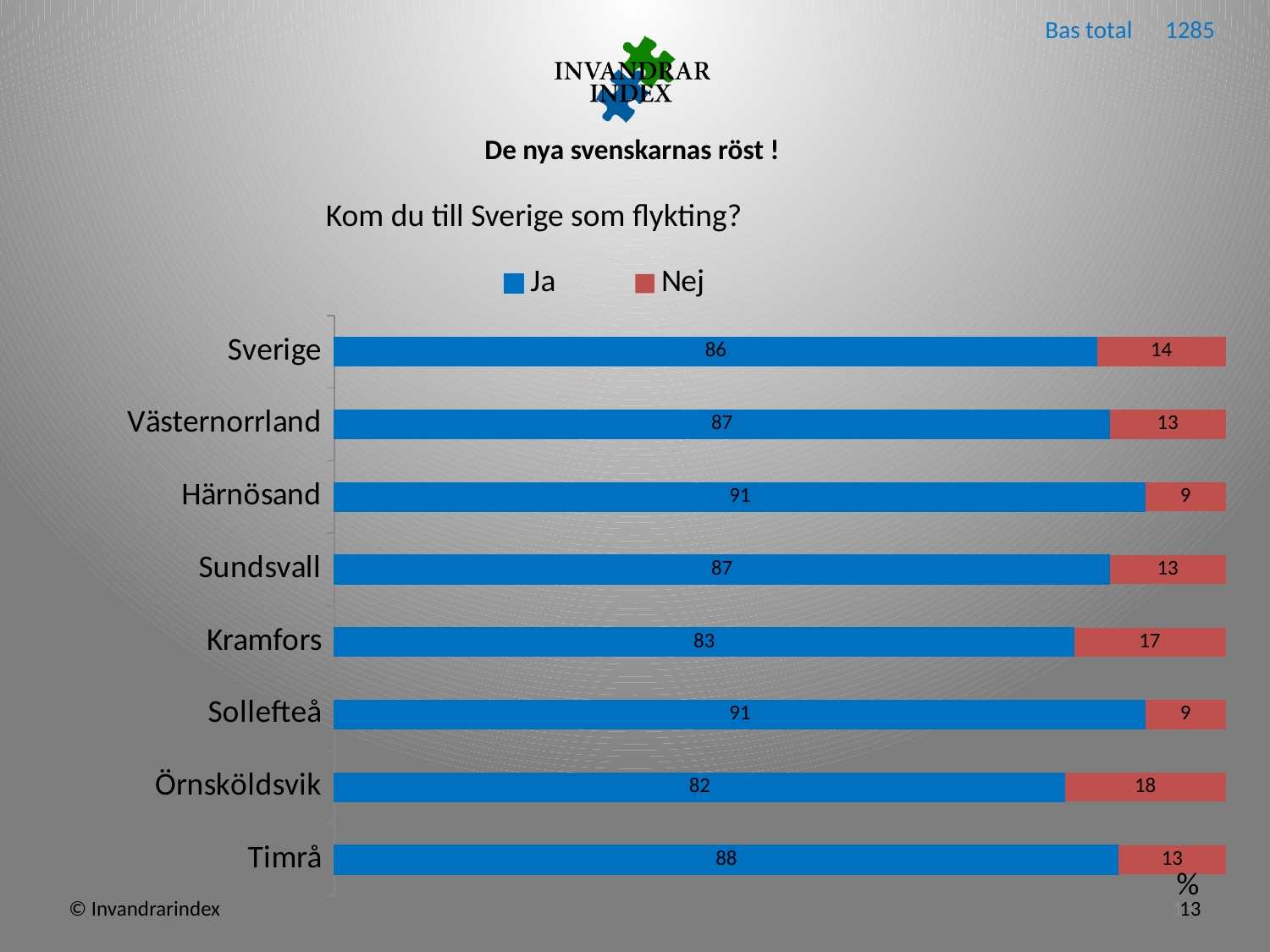
What is the total of the stacked bar for Sverige? 100 Which is larger, the Ja value for Sundsvall or the Ja value for Örnsköldsvik? Sundsvall Which category has the lowest value for Ja? Örnsköldsvik How many series does the legend list? 2 How many categories are shown on the chart? 8 What is the value for Ja for Timrå? 88 What kind of chart is shown on the slide? Stacked bar chart What is the value for Ja for Sverige? 86 What is the value for Nej for Kramfors? 17 What is the value for Nej for Härnösand? 9 What is the difference between the Ja values for Härnösand and Kramfors? 8 Which category has the highest value for Nej? Örnsköldsvik